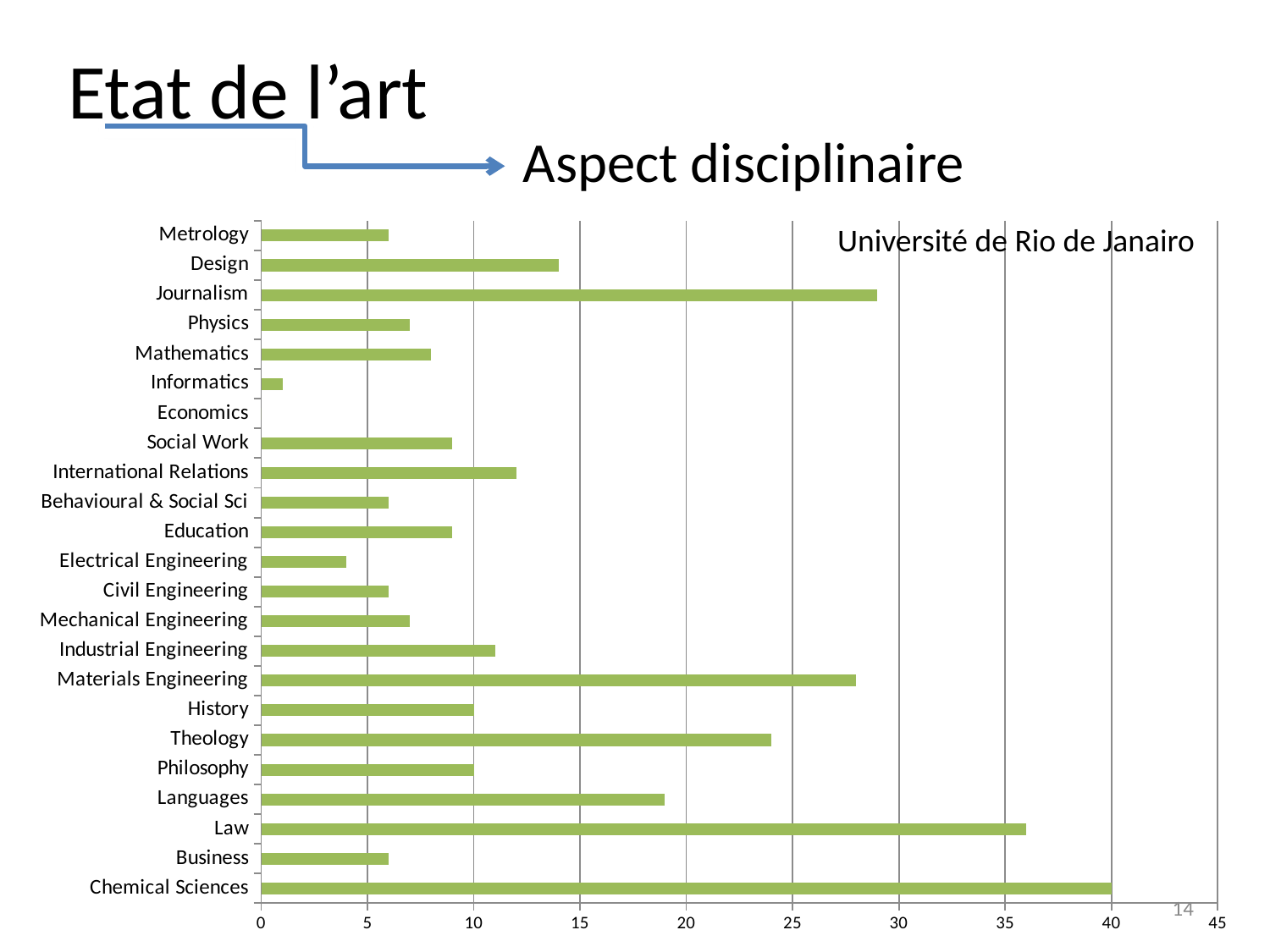
Is the value for Law greater or less than 35? greater Which category has the highest value in the chart? Chemical Sciences What kind of chart is shown on the slide? bar chart How many categories are shown in the chart? 23 Which is larger, the value for Law or the value for Journalism? Law Which university is named in the text on the chart? Université de Rio de Janairo What is the value for History? 10 Is the value for Theology greater or less than 25? less Is the value for Journalism greater or less than 25? greater Which category has the lowest value in the chart? Economics What is the value for Chemical Sciences? 40